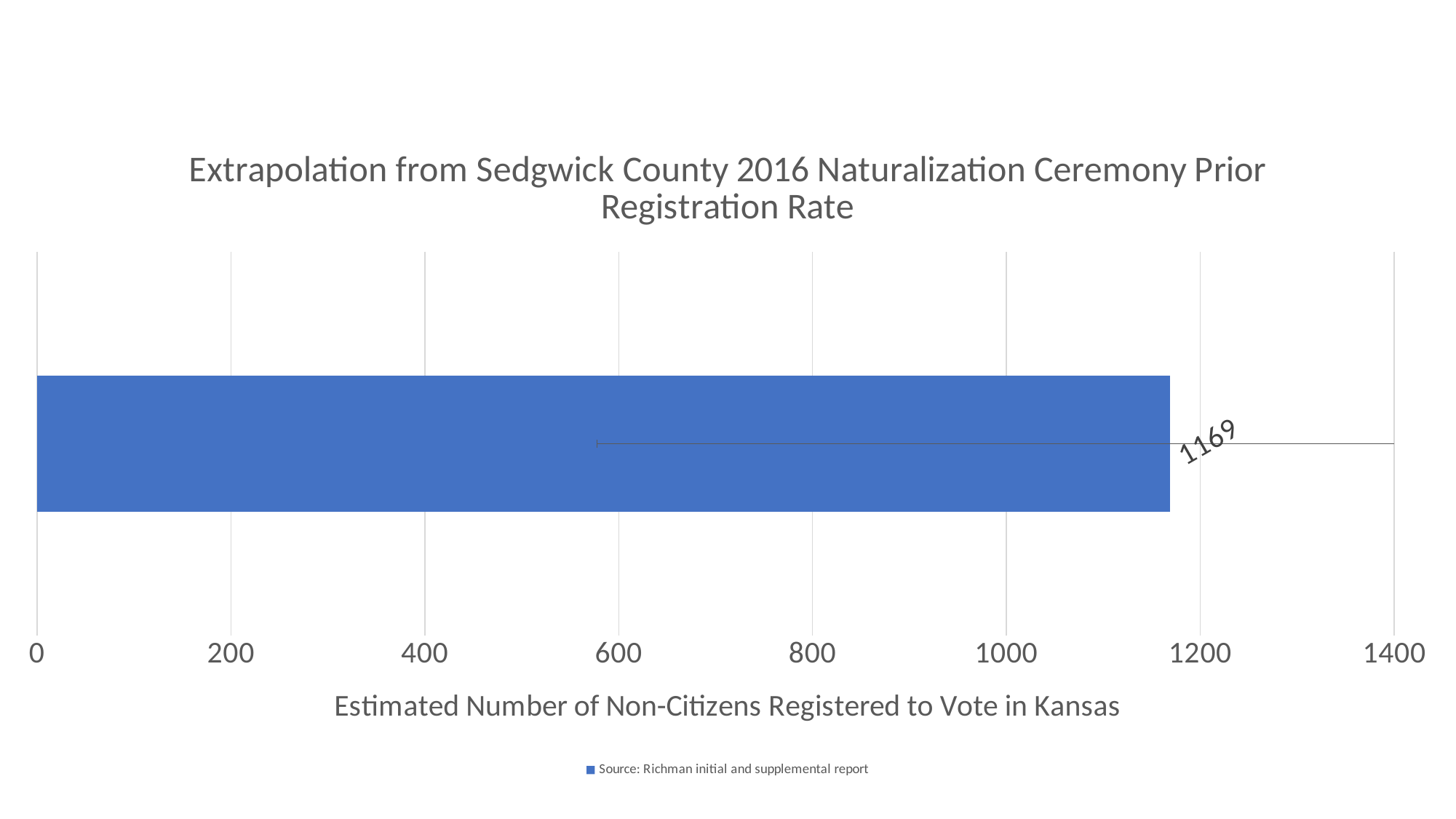
What is the label on the horizontal axis? Estimated Number of Non-Citizens Registered to Vote in Kansas What kind of chart is shown on the slide? bar chart Is the value of the bar greater or less than 1000? greater How many series does the legend list? 1 Is the value of the bar greater or less than 1200? less How many bars are plotted in the chart? 1 What is the value shown by the data label on the bar? 1169 What is the maximum value shown on the horizontal axis? 1400 What is the title of the chart? Extrapolation from Sedgwick County 2016 Naturalization Ceremony Prior Registration Rate